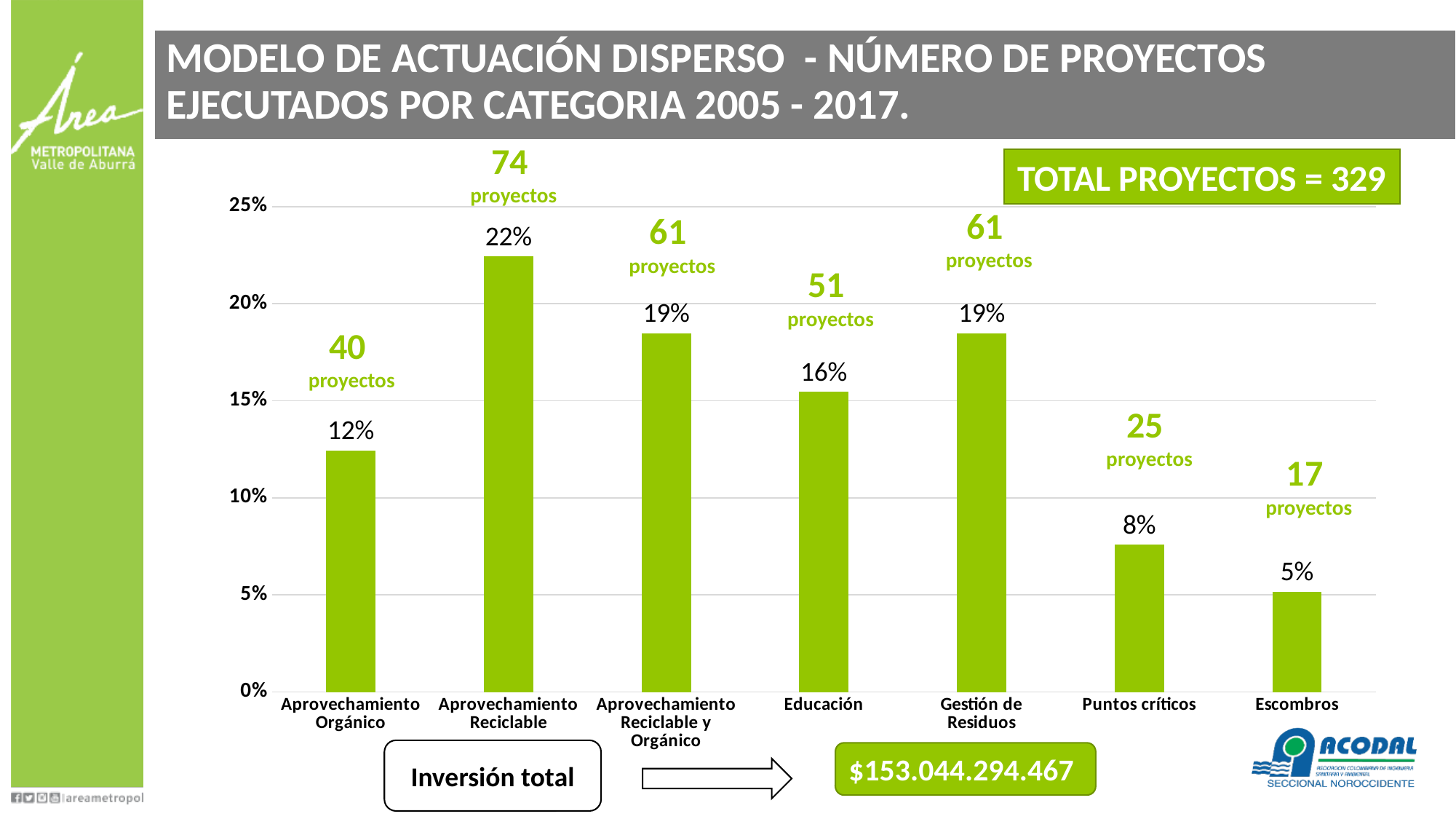
What percentage is shown for Educación? 16% How many categories are shown on the x axis? 7 Which category has the lowest percentage? Escombros What percentage is shown for Aprovechamiento Reciclable? 22% How many projects are annotated for Puntos críticos? 25 proyectos Which is larger, the percentage for Aprovechamiento Orgánico or for Educación? Educación What kind of chart is shown on the slide? bar chart What total number of projects is stated on the slide? 329 What is the total investment (Inversión total) shown on the slide? $153.044.294.467 Which category has the highest percentage? Aprovechamiento Reciclable What is the difference in percentage points between Aprovechamiento Reciclable and Escombros? 17 Is the value for Gestión de Residuos greater or less than 15%? greater